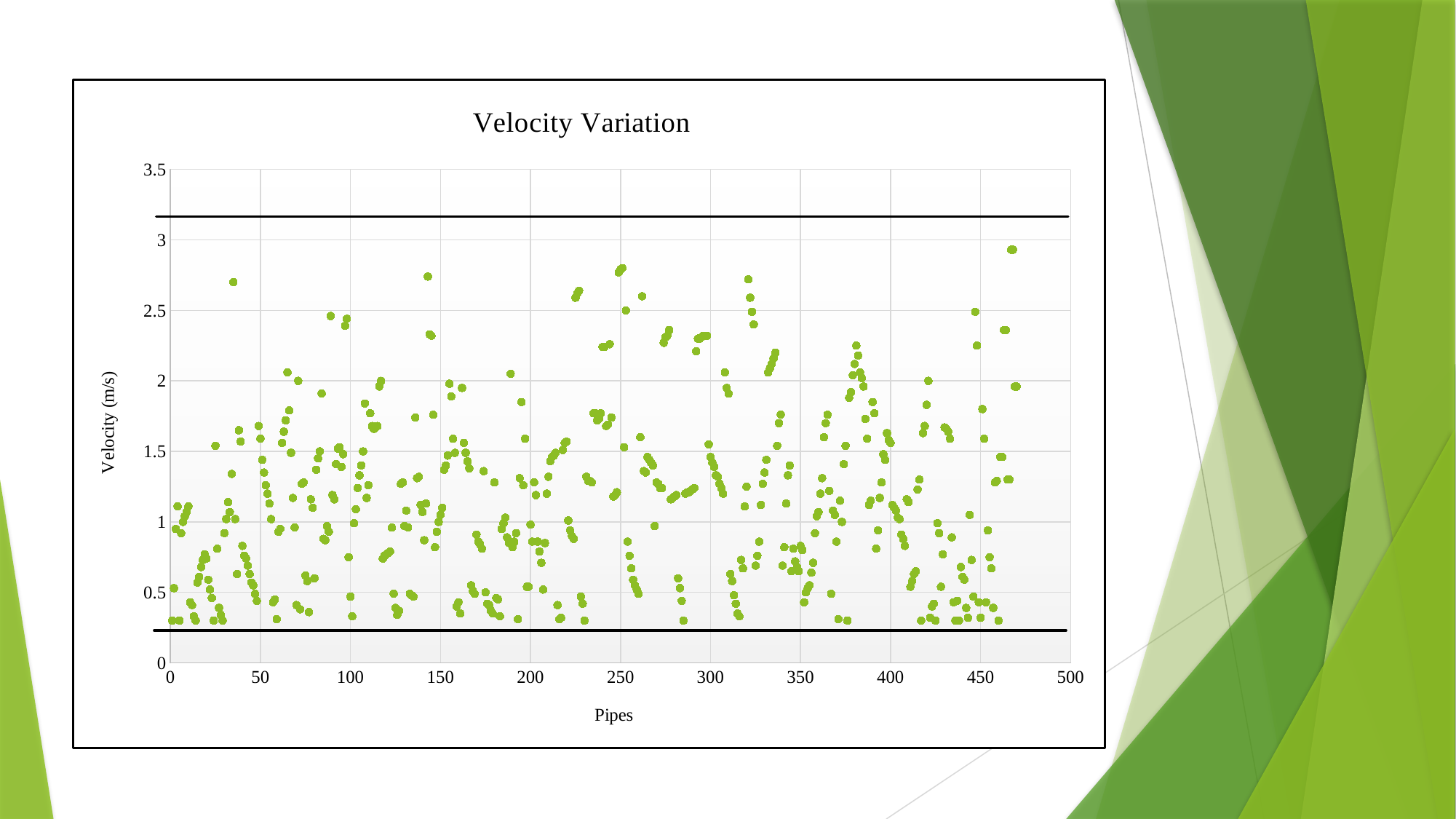
Is the lowest plotted velocity greater or less than 0.5? less What is the title of the chart? Velocity Variation What is the highest tick value shown on the horizontal axis? 500 What kind of chart is shown on the slide? scatter chart Is the highest plotted velocity greater or less than 3? less Is the lower horizontal black line drawn at a velocity greater or less than 0.5? less Do any plotted points lie above the upper horizontal black line? No What is the label of the vertical axis? Velocity (m/s) What is the highest tick value shown on the vertical axis? 3.5